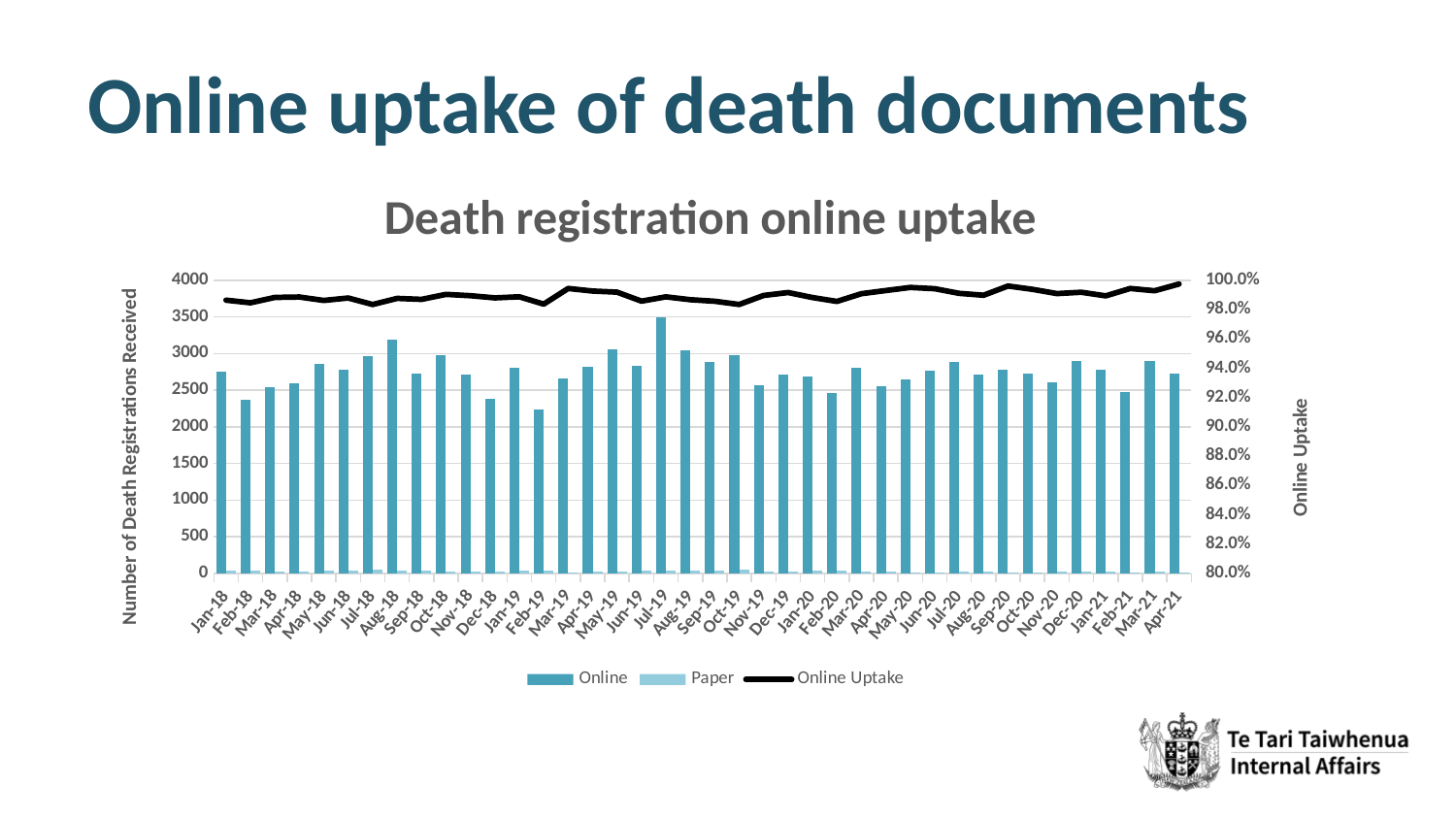
What is the title of the chart? Death registration online uptake Which month has the lowest Online bar? Feb-19 Is the Online value for Jul-19 greater or less than 3000? greater How many series does the chart legend list? 3 Is the Online Uptake line for every month greater or less than 96.0%? greater Is the Online value for Feb-19 greater or less than 2500? less What kind of chart is shown on the slide? Bar chart with a line What is the label on the left vertical axis of the chart? Number of Death Registrations Received Which month has the highest Online bar? Jul-19 How many months are shown along the x axis of the chart? 40 Which is larger, the Online value for Jan-18 or for Feb-18? Jan-18